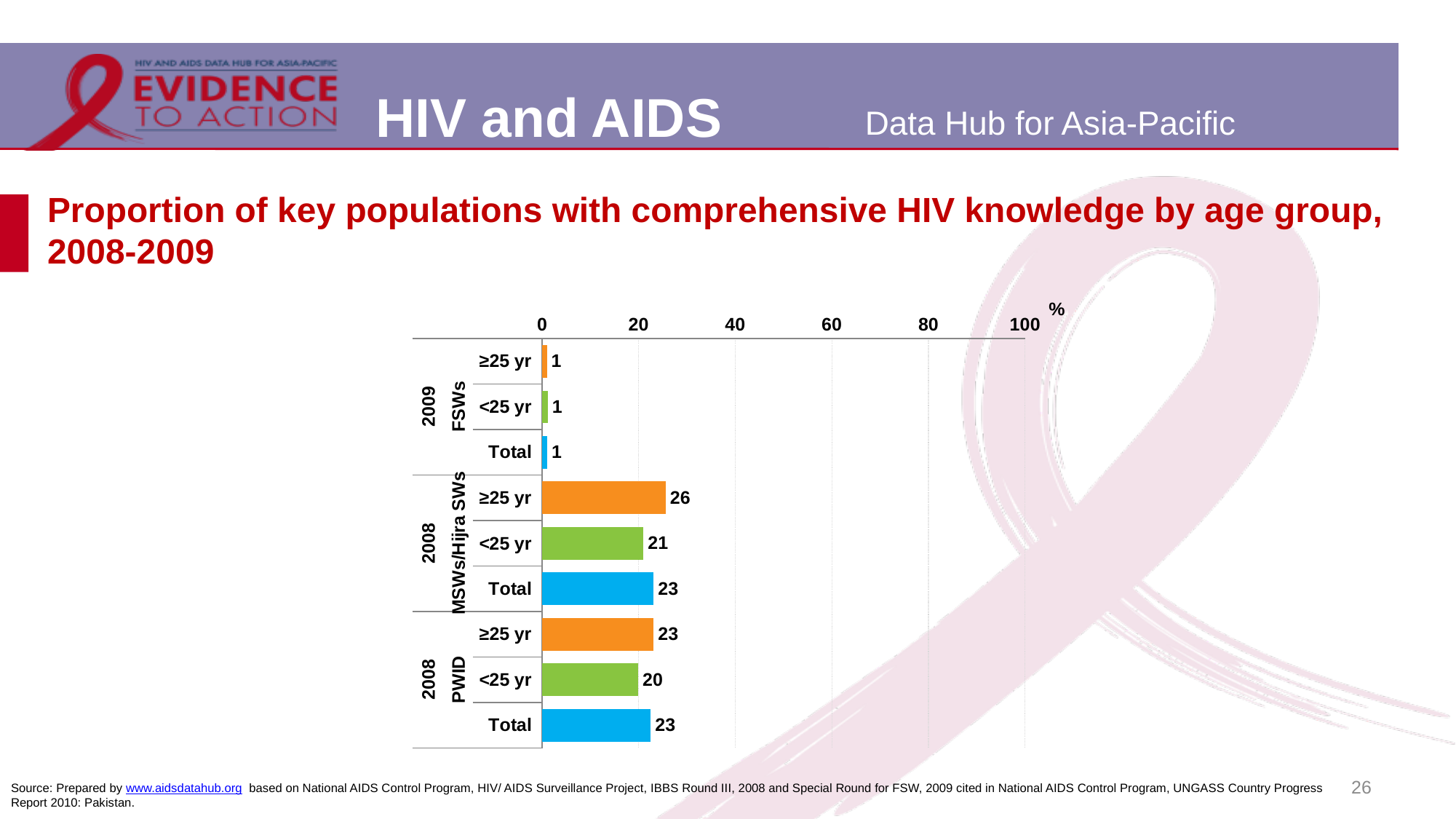
What is the difference between the ≥25 yr and <25 yr values for MSWs/Hijra SWs (2008)? 5 How many bars are plotted on the chart? 9 What kind of chart is shown on the slide? bar chart Which bar has the highest value on the chart? MSWs/Hijra SWs (2008) ≥25 yr What is the difference between the ≥25 yr and <25 yr values for PWID (2008)? 3 Which is larger: the <25 yr value for MSWs/Hijra SWs (2008) or the <25 yr value for PWID (2008)? MSWs/Hijra SWs (2008) What is the value for the <25 yr group among PWID (2008)? 20 What is the Total value for PWID (2008)? 23 What is the Total value for FSWs (2009)? 1 What is the maximum value shown on the horizontal axis? 100 Is the Total value for MSWs/Hijra SWs (2008) greater or less than 40? less What is the value for the ≥25 yr group among MSWs/Hijra SWs (2008)? 26